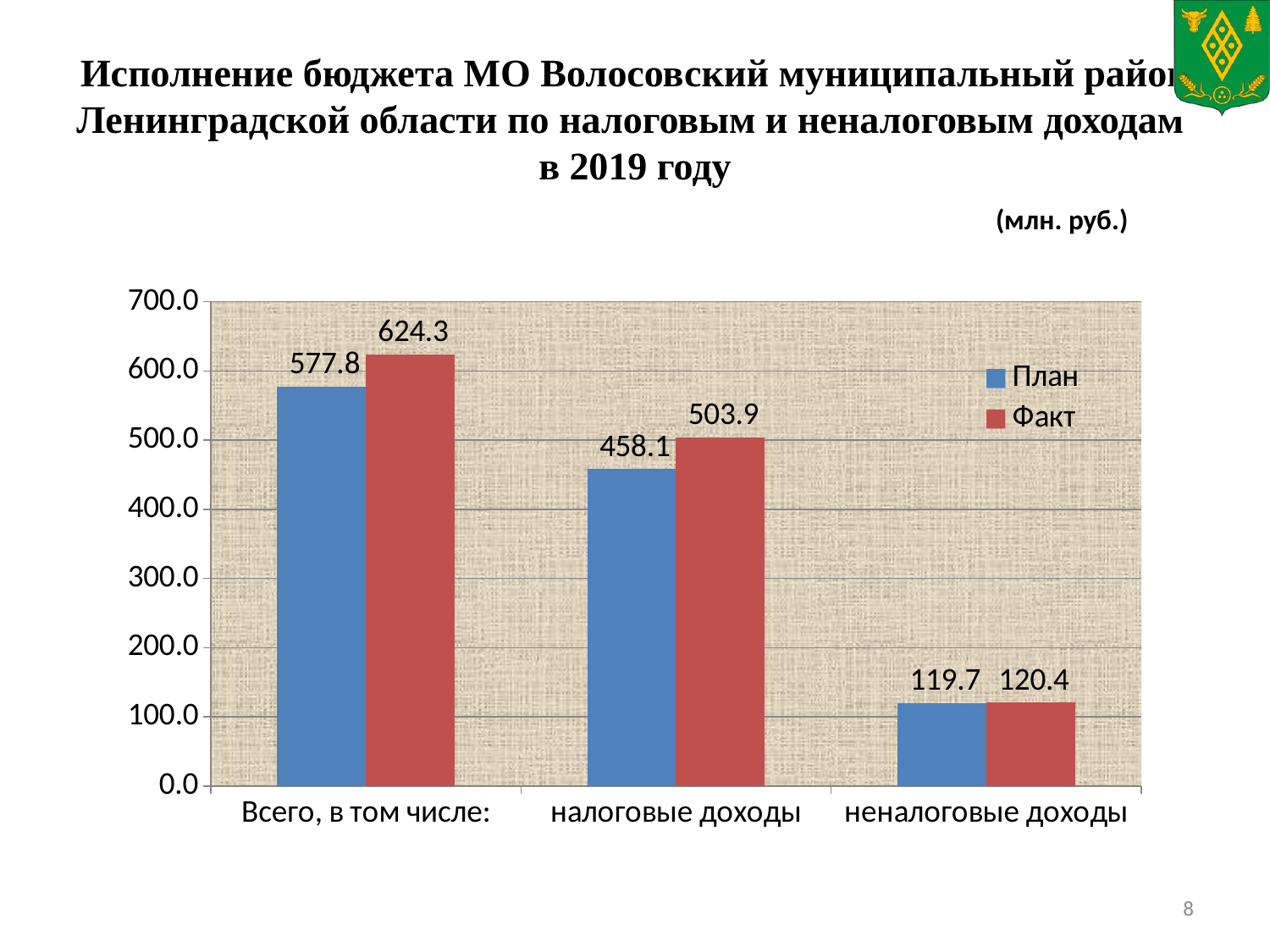
How many series does the legend list? 2 What is the План value for "Всего, в том числе:"? 577.8 What is the Факт value for "налоговые доходы"? 503.9 Which category has the lowest Факт value? неналоговые доходы Which category has the highest План value? Всего, в том числе: What is the План value for "налоговые доходы"? 458.1 What is the Факт value for "неналоговые доходы"? 120.4 What kind of chart is shown on the slide? bar chart What is the difference between the Факт and План values for "Всего, в том числе:"? 46.5 What is the difference between the Факт and План values for "налоговые доходы"? 45.8 How many categories are shown on the x axis? 3 Which is larger for "налоговые доходы": the План value or the Факт value? Факт